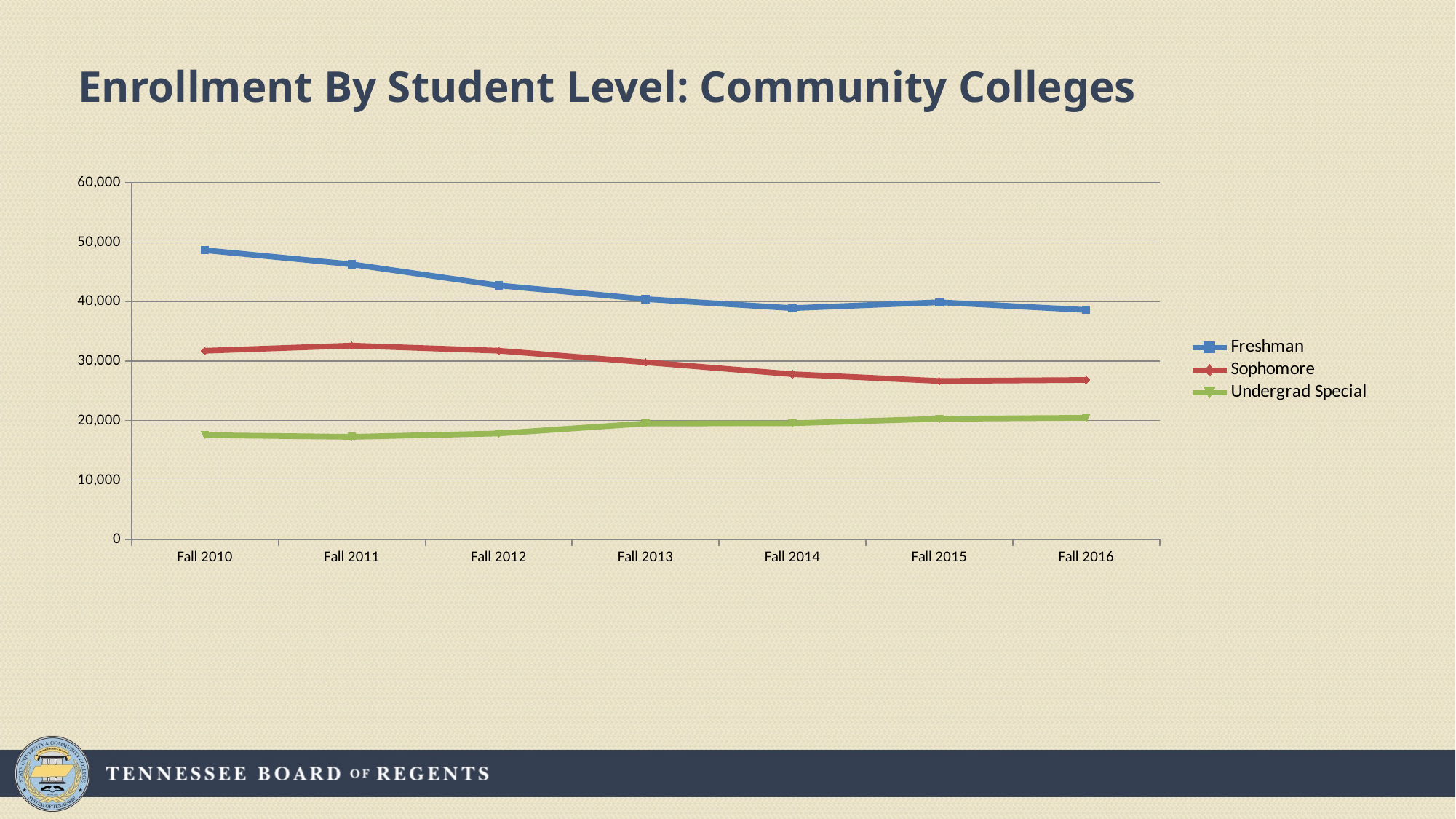
How many series does the legend list? 3 In which Fall term is Freshman enrollment highest? Fall 2010 Is the Freshman value for Fall 2010 greater or less than 50,000? less How many Fall terms are plotted along the x axis? 7 What kind of chart is shown on the slide? line chart Is the Sophomore value for Fall 2014 greater or less than 30,000? less What colour is the Sophomore line in the chart? red In which Fall term is Sophomore enrollment highest? Fall 2011 Does Freshman enrollment generally rise or fall from Fall 2010 to Fall 2016? fall In Fall 2013, which is larger, Freshman or Sophomore enrollment? Freshman Is the Freshman value for Fall 2010 greater or less than 40,000? greater